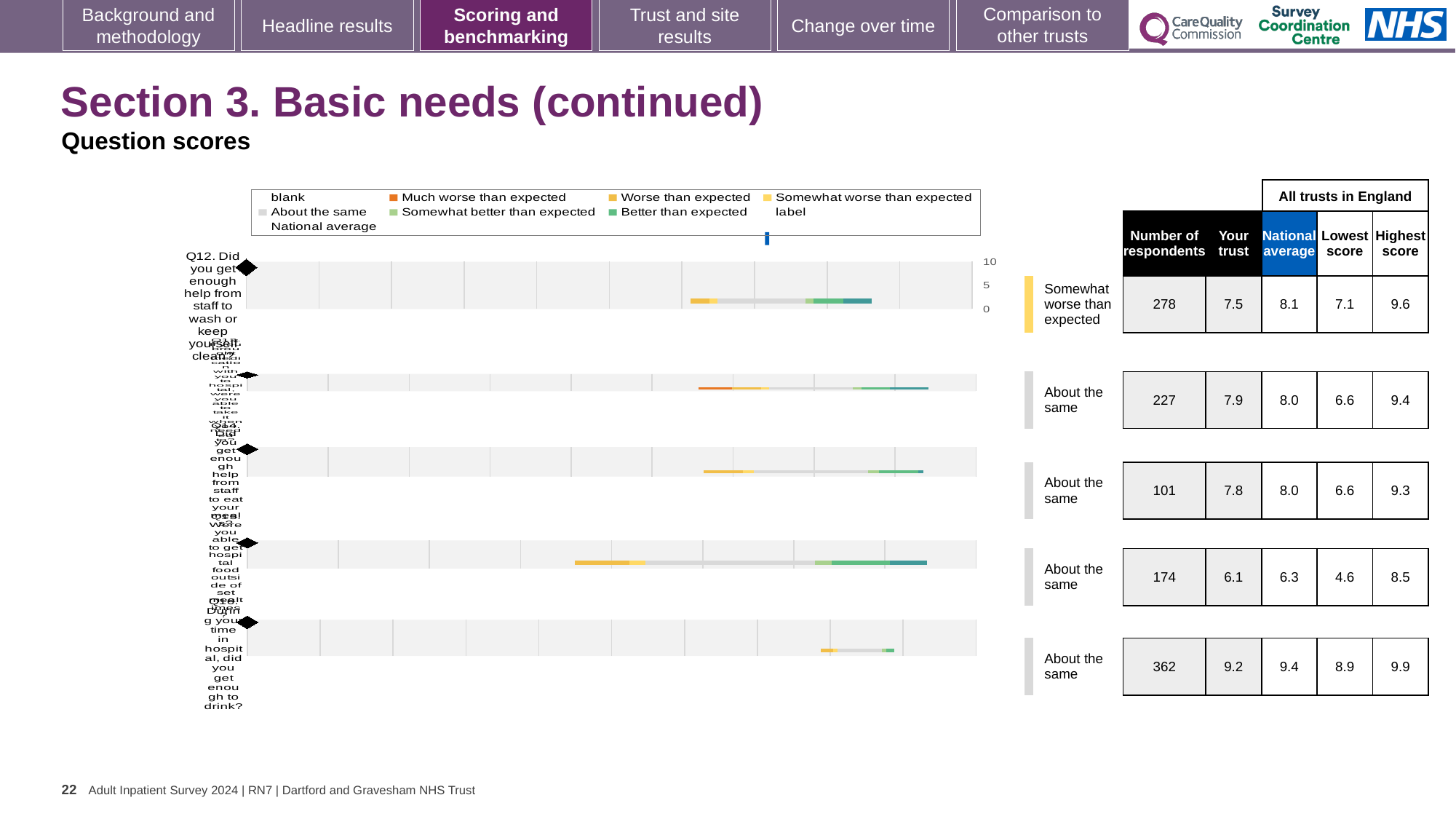
Which question row has the largest number of respondents? the last (fifth) row, 362 What is the 'Your trust' score for Q12 (help from staff to wash or keep yourself clean)? 7.5 What benchmark category is shown for Q12, the first bar in the chart? Somewhat worse than expected Is the trust score for the fourth question row larger or smaller than its national average? smaller What is the difference between the national average and the trust score for Q12? 0.6 What kind of chart is used to show the question scores on this slide? bar chart How many respondents answered Q12 (help from staff to wash or keep yourself clean)? 278 How many question bars are plotted in the chart? 5 What is the national average for Q12 (help from staff to wash or keep yourself clean)? 8.1 Which question row has the highest 'Your trust' score? the last (fifth) row, 9.2 What is the highest score among all trusts in England for the last (fifth) question row? 9.9 Which question row has the lowest 'Your trust' score? the fourth row, 6.1